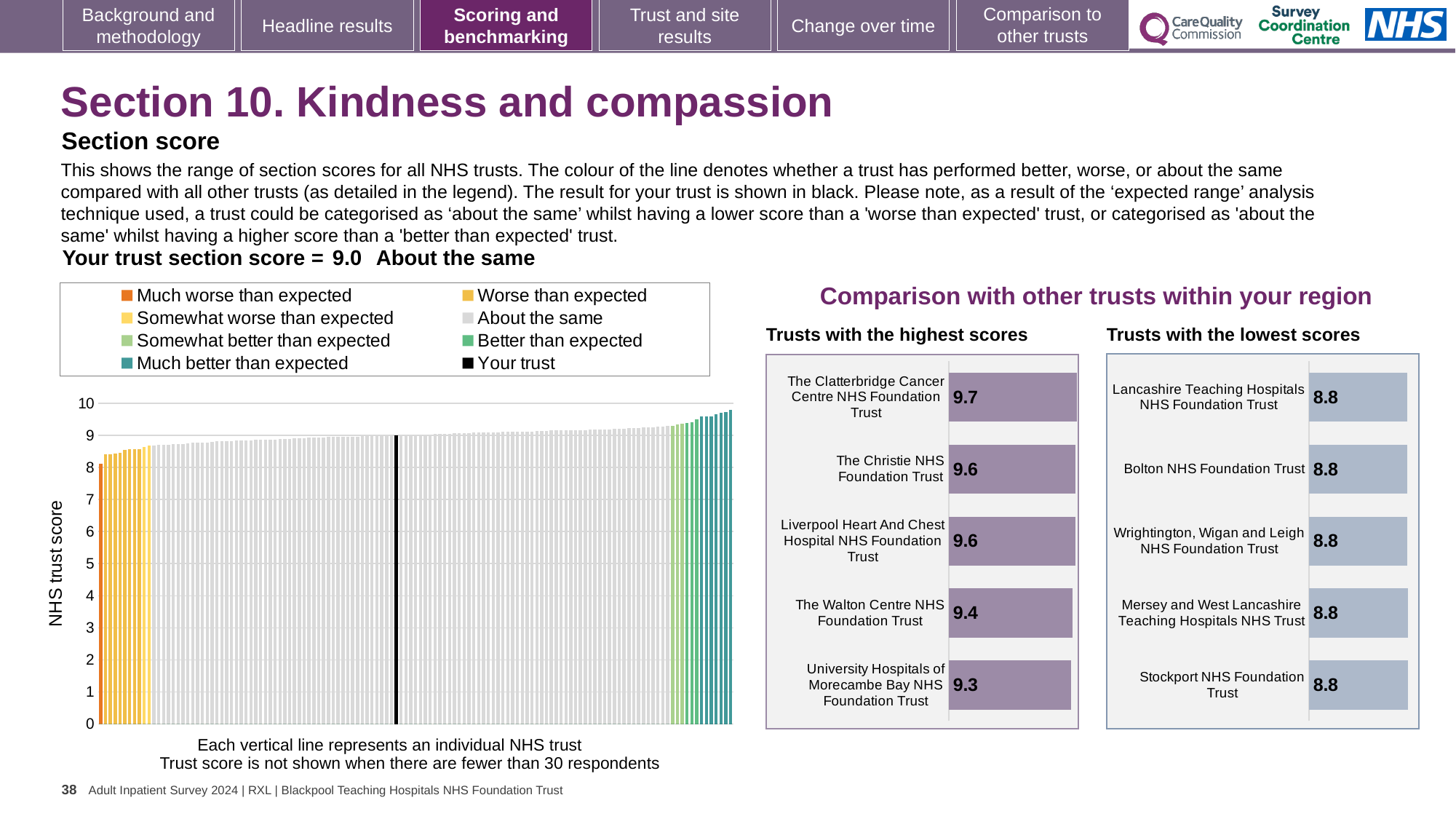
On the 'Trusts with the highest scores' chart, what is the difference between the scores of The Clatterbridge Cancer Centre NHS Foundation Trust and University Hospitals of Morecambe Bay NHS Foundation Trust? 0.4 On the 'Trusts with the lowest scores' chart, how many trusts are listed? 5 On the section score chart on the left, what is the section score for your trust? 9.0 On the 'Trusts with the highest scores' chart, what is the score for The Walton Centre NHS Foundation Trust? 9.4 On the 'Trusts with the lowest scores' chart, what is the score for Stockport NHS Foundation Trust? 8.8 On the 'Trusts with the lowest scores' chart, what is the score for Bolton NHS Foundation Trust? 8.8 On the 'Trusts with the highest scores' chart, what is the score for The Clatterbridge Cancer Centre NHS Foundation Trust? 9.7 On the 'Trusts with the highest scores' chart, which trust has the lowest score? University Hospitals of Morecambe Bay NHS Foundation Trust On the 'Trusts with the highest scores' chart, how many trusts are shown? 5 On the section score chart on the left, how many entries does the legend list? 8 On the section score chart on the left, do the trust scores rise or fall from left to right? rise On the 'Trusts with the highest scores' chart, which trust has the highest score? The Clatterbridge Cancer Centre NHS Foundation Trust